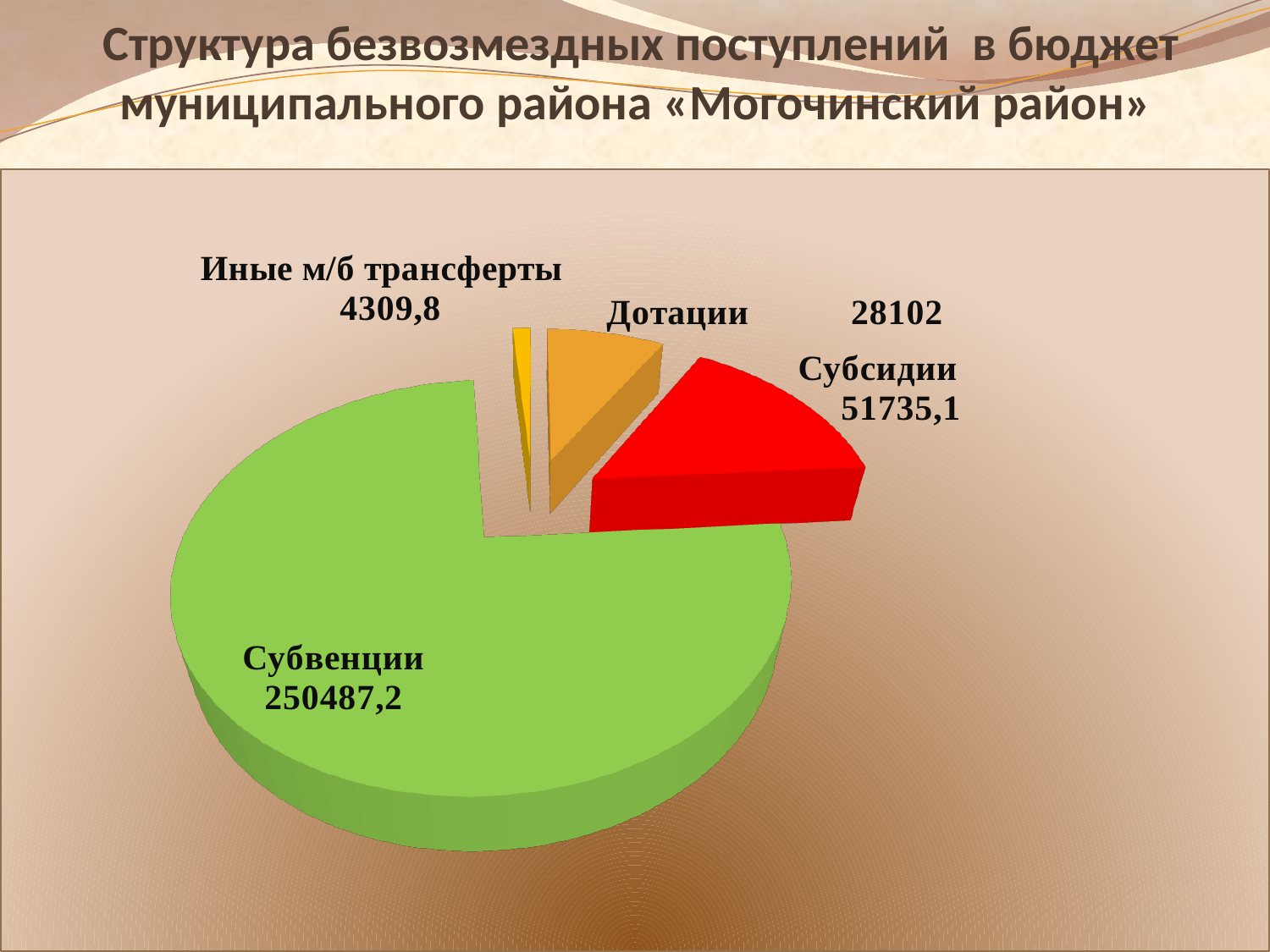
What is the value for Иные м/б трансферты? 4309,8 What kind of chart is shown on the slide? Pie chart What is the value for Дотации? 28102 Which is larger, Субсидии or Дотации? Субсидии How many slices does the pie chart have? 4 What is the value for Субвенции? 250487,2 What colour is the Субвенции slice? Green What is the difference between Субсидии and Дотации? 23633,1 Which category has the largest slice of the pie? Субвенции What is the value for Субсидии? 51735,1 Which category has the smallest slice of the pie? Иные м/б трансферты What is the difference between Субвенции and Субсидии? 198752,1